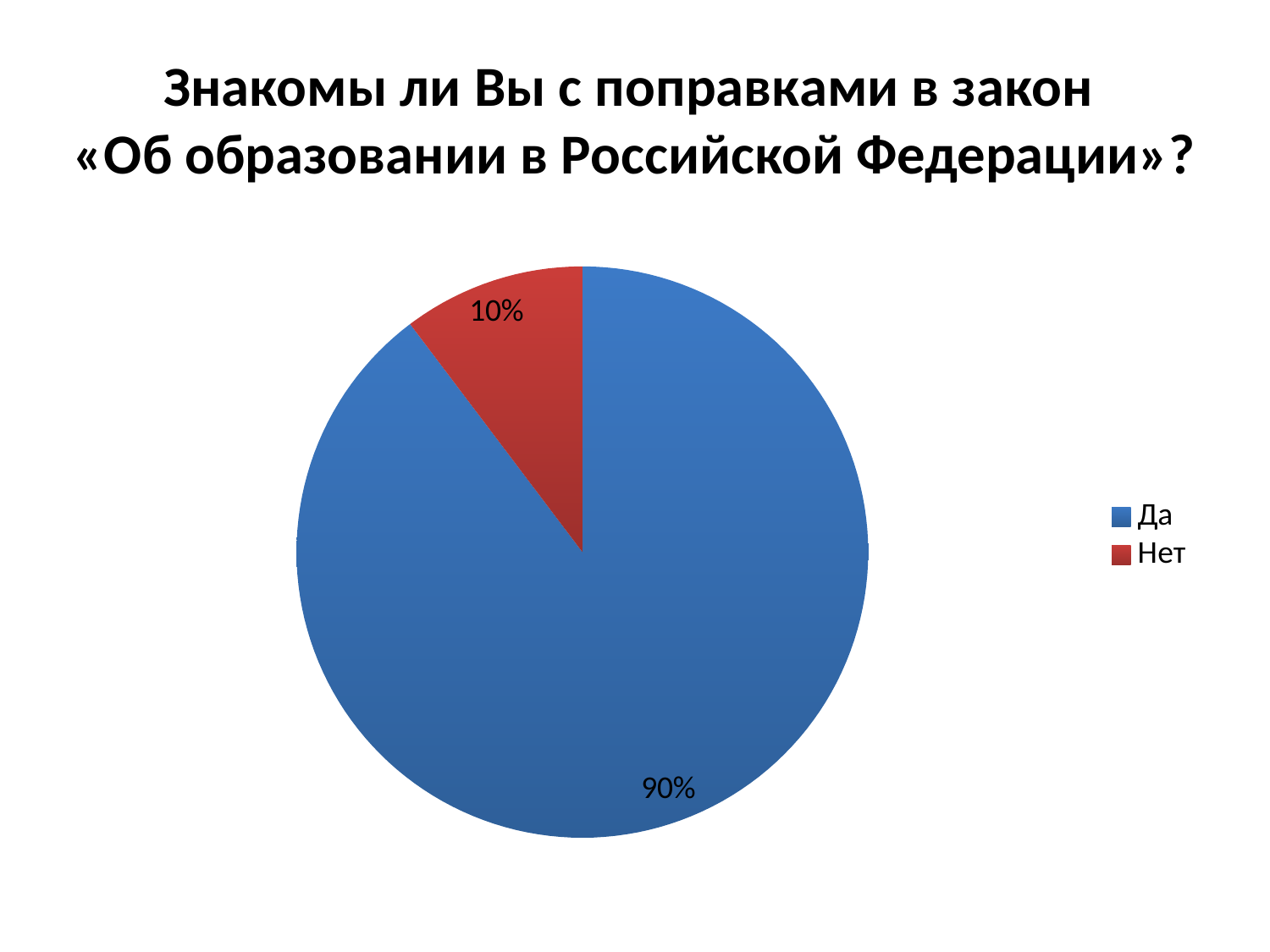
What is the difference in percentage points between the "Да" and "Нет" slices? 80% Which category has the largest slice of the pie? Да What colour is the "Да" slice? blue What share of the pie does "Да" take? 90% Which category has the smallest slice of the pie? Нет Which slice is larger, "Да" or "Нет"? Да How many entries does the legend list? 2 What share of the pie does "Нет" take? 10% What kind of chart is shown on the slide? pie chart What colour is the "Нет" slice? red How many categories does the pie chart show? 2